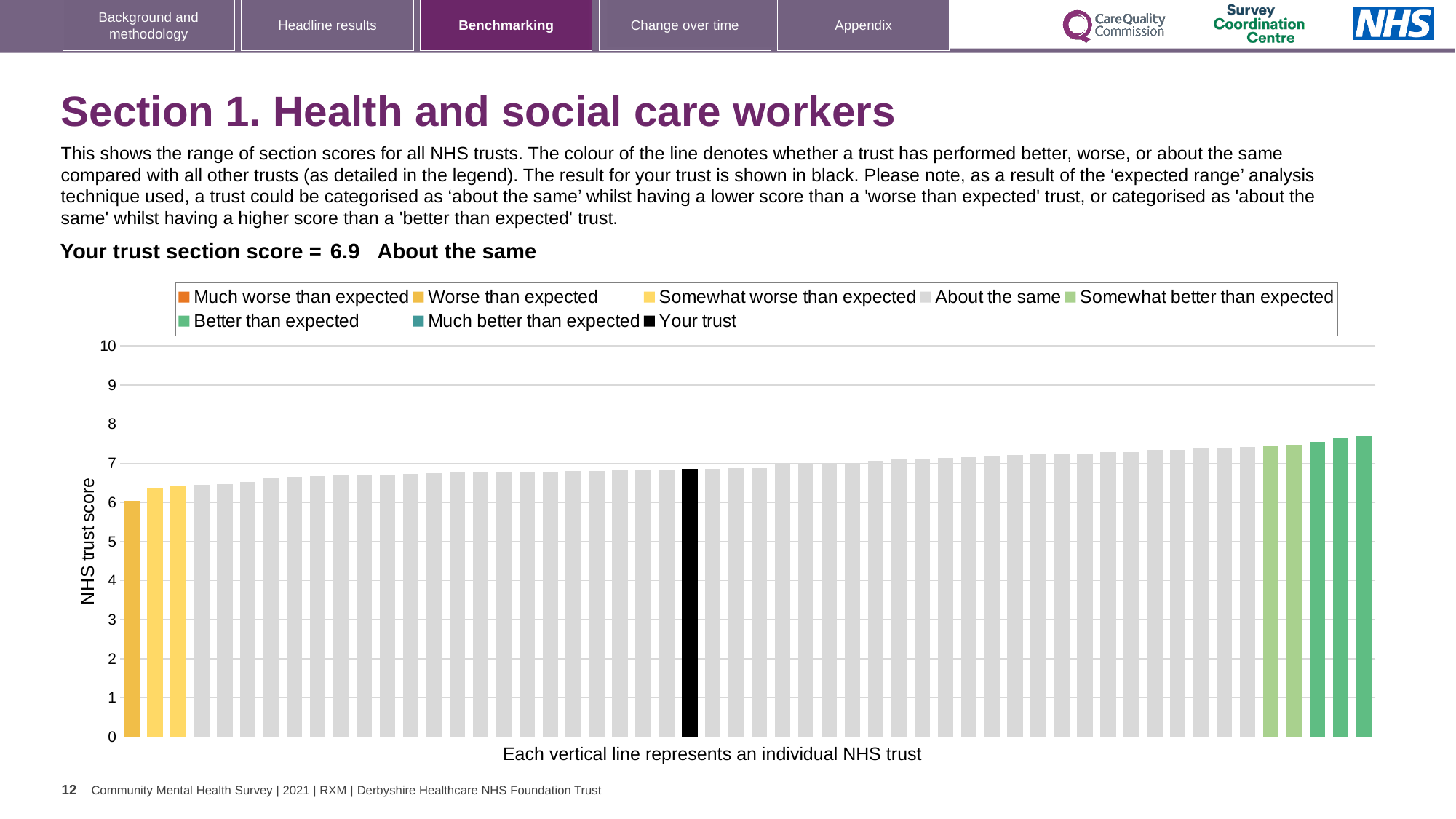
Is the value of the highest bar greater or less than 8? less What is the label on the vertical axis of the chart? NHS trust score What kind of chart is shown on the slide? bar chart Which legend category does the highest bar on the chart belong to? Better than expected What is the section score for your trust shown on the slide? 6.9 How many bars are coloured as 'Somewhat worse than expected'? 2 How many entries does the chart legend list? 8 Is the value of the lowest bar greater or less than 7? less Is the value of the highest bar greater or less than 7? greater Do the bar values rise or fall from left to right along the x axis? rise Which category is your trust's section score placed in? About the same Which legend category does the lowest bar on the chart belong to? Worse than expected